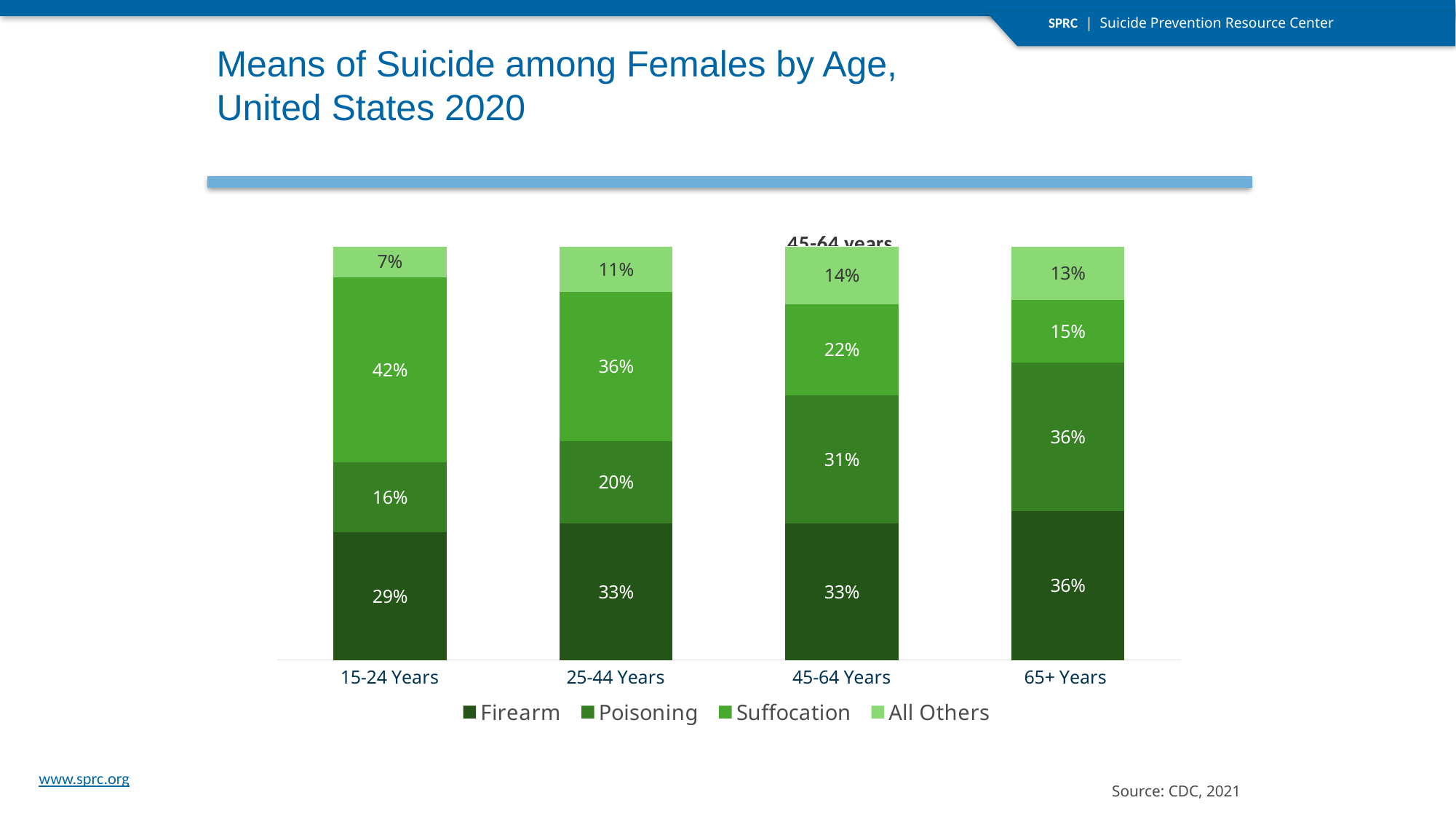
What is the difference between the Suffocation values for 15-24 Years and 65+ Years? 27 percentage points How many age groups are shown on the x axis? 4 What is the Poisoning value for the 45-64 Years age group? 31% Which age group has the highest Suffocation percentage? 15-24 Years How many series does the legend list? 4 Which is larger, the Poisoning value for 25-44 Years or the Poisoning value for 45-64 Years? 45-64 Years What type of chart is shown on the slide? Stacked bar chart What is the Firearm value for the 65+ Years age group? 36% What percentage of suicides among females aged 15-24 years were by suffocation? 42% What is the All Others value for the 25-44 Years age group? 11% Does the Firearm percentage rise or fall as age increases from 15-24 Years to 65+ Years? Rises Which age group has the lowest Poisoning percentage? 15-24 Years